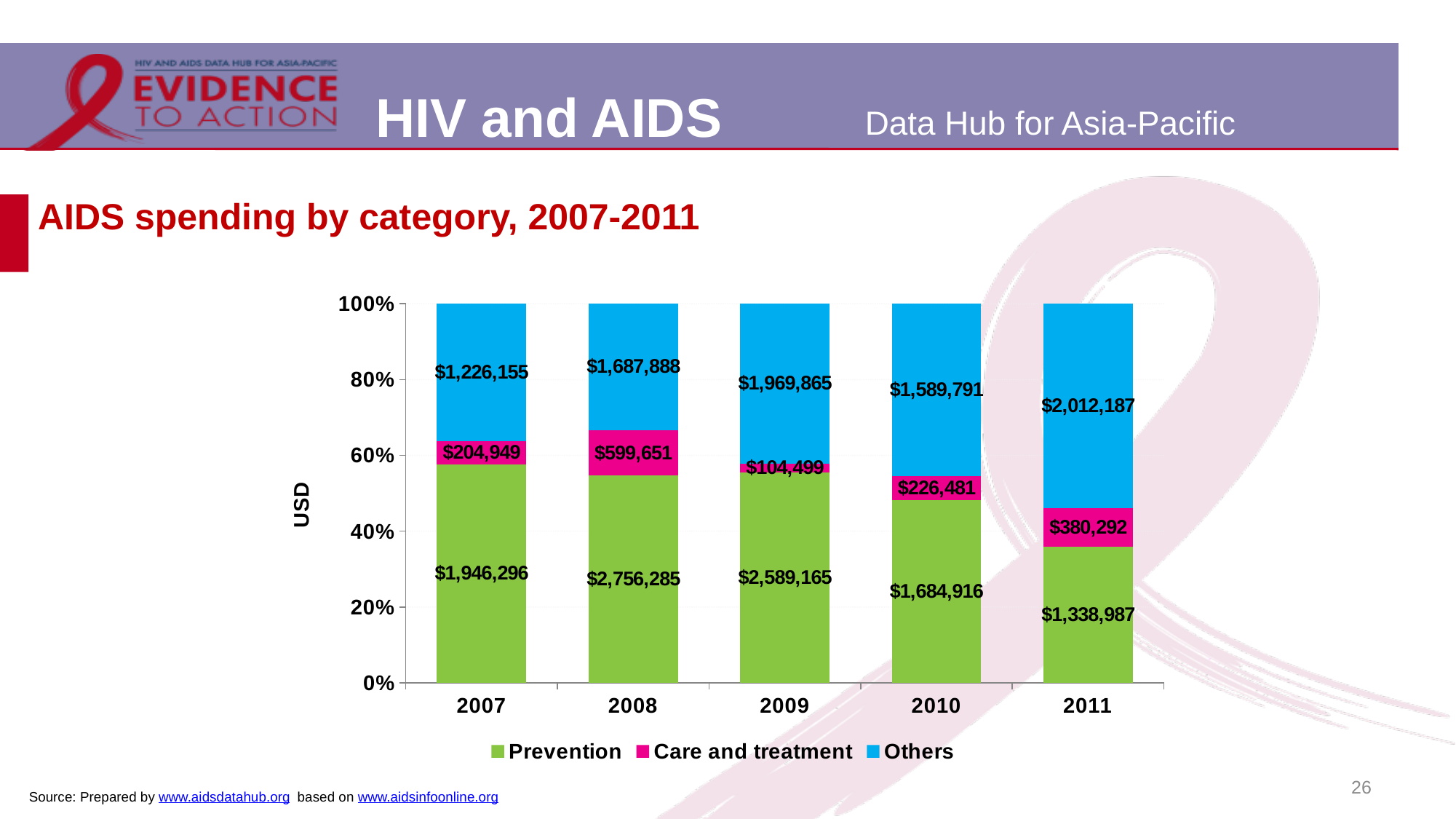
What was the Others spending in 2009? $1,969,865 In which year was Prevention spending highest? 2008 What type of chart is shown on the slide? Stacked bar chart How many years are shown on the x axis? 5 What is the total AIDS spending across all three categories in 2007? $3,377,400 What was the Care and treatment spending in 2010? $226,481 What is the difference between Prevention spending in 2008 and in 2011? $1,417,298 Which is larger: Others spending in 2011 or Others spending in 2007? Others spending in 2011 What was the Prevention spending in 2008? $2,756,285 In which year was Care and treatment spending lowest? 2009 Is the Prevention share of the 2011 bar greater or less than 40%? less How many series does the legend list? 3